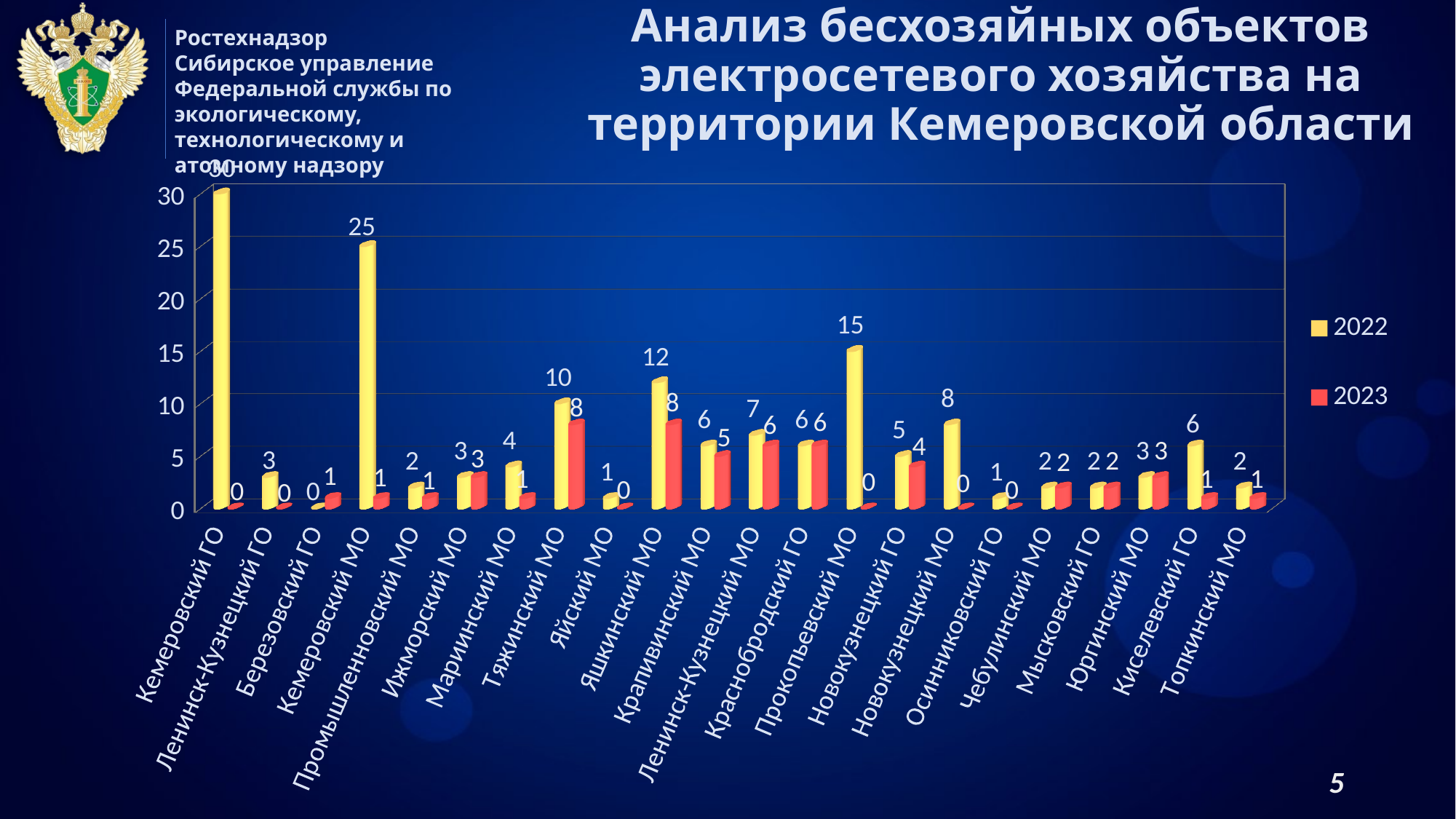
What is the 2023 value for Крапивинский МО? 5 Which colour represents the 2023 series in the legend? Red Which category has the highest 2022 value? Кемеровский ГО What is the 2022 value for Прокопьевский МО? 15 What is the 2022 value for Кемеровский МО? 25 What kind of chart is shown on the slide? Bar chart How many categories are shown on the x axis? 22 Which category has the lowest 2022 value? Березовский ГО What is the difference between the 2022 and 2023 values for Яшкинский МО? 4 What is the 2023 value for Тяжинский МО? 8 Which is larger for Новокузнецкий МО: the 2022 value or the 2023 value? 2022 How many series does the legend list? 2